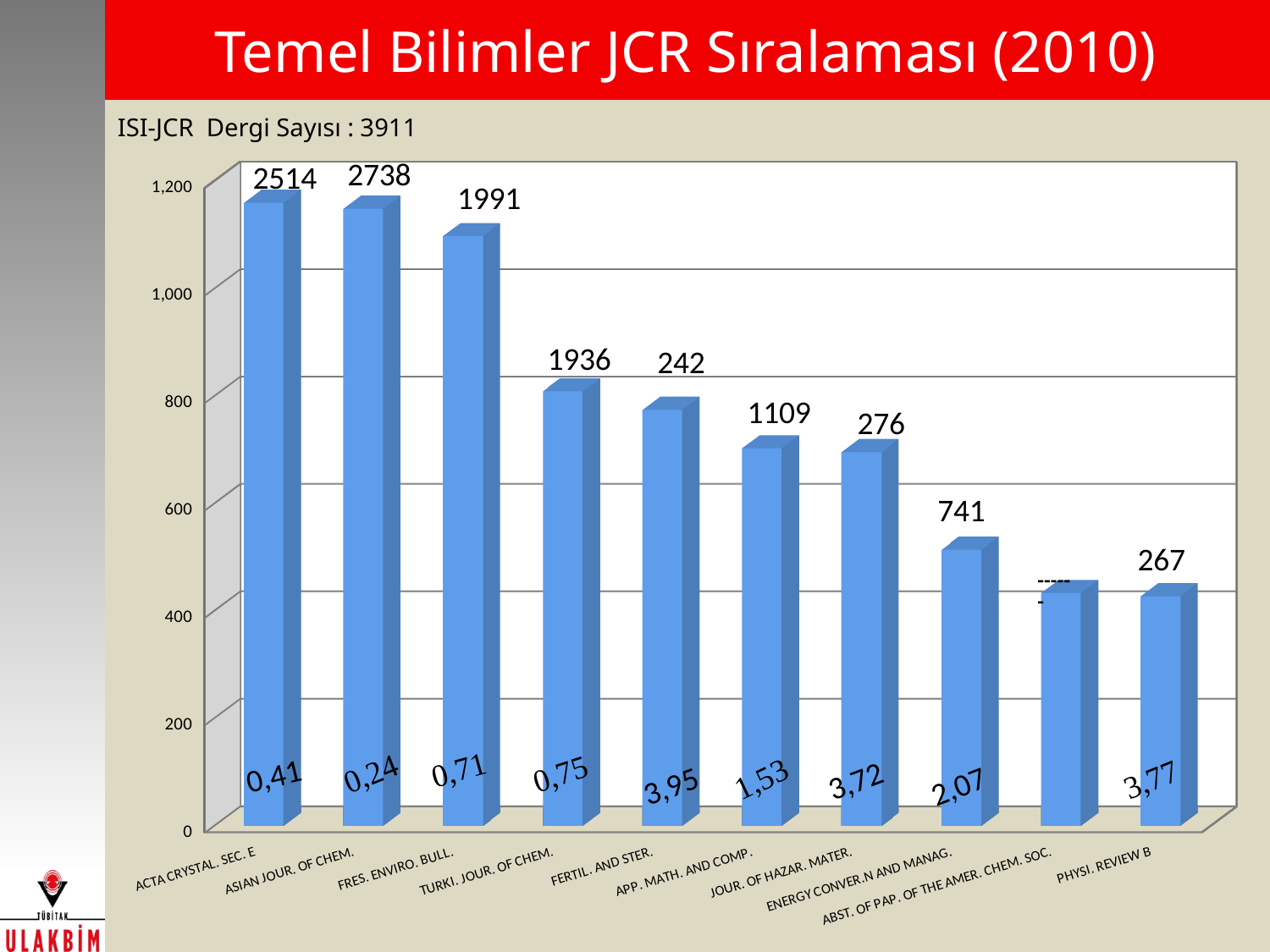
What value is printed at the base of the bar for ACTA CRYSTAL. SEC. E? 0,41 What value is printed at the base of the bar for FERTIL. AND STER.? 3,95 Is the bar for TURKI. JOUR. OF CHEM. greater or less than 1,000 on the vertical axis? less What type of chart is shown on the slide? bar chart Is the bar for ACTA CRYSTAL. SEC. E greater or less than 1,000 on the vertical axis? greater Is the bar for ENERGY CONVER.N AND MANAG. greater or less than 600 on the vertical axis? less What is the title of the slide containing the chart? Temel Bilimler JCR Sıralaması (2010) What number is printed above the bar for FRES. ENVIRO. BULL.? 1991 Which bar is taller: ACTA CRYSTAL. SEC. E or TURKI. JOUR. OF CHEM.? ACTA CRYSTAL. SEC. E How many journals (categories) are shown on the x axis of the chart? 10 Do the bar heights generally rise or fall from left to right along the x axis? fall What number is printed above the bar for ASIAN JOUR. OF CHEM.? 2738